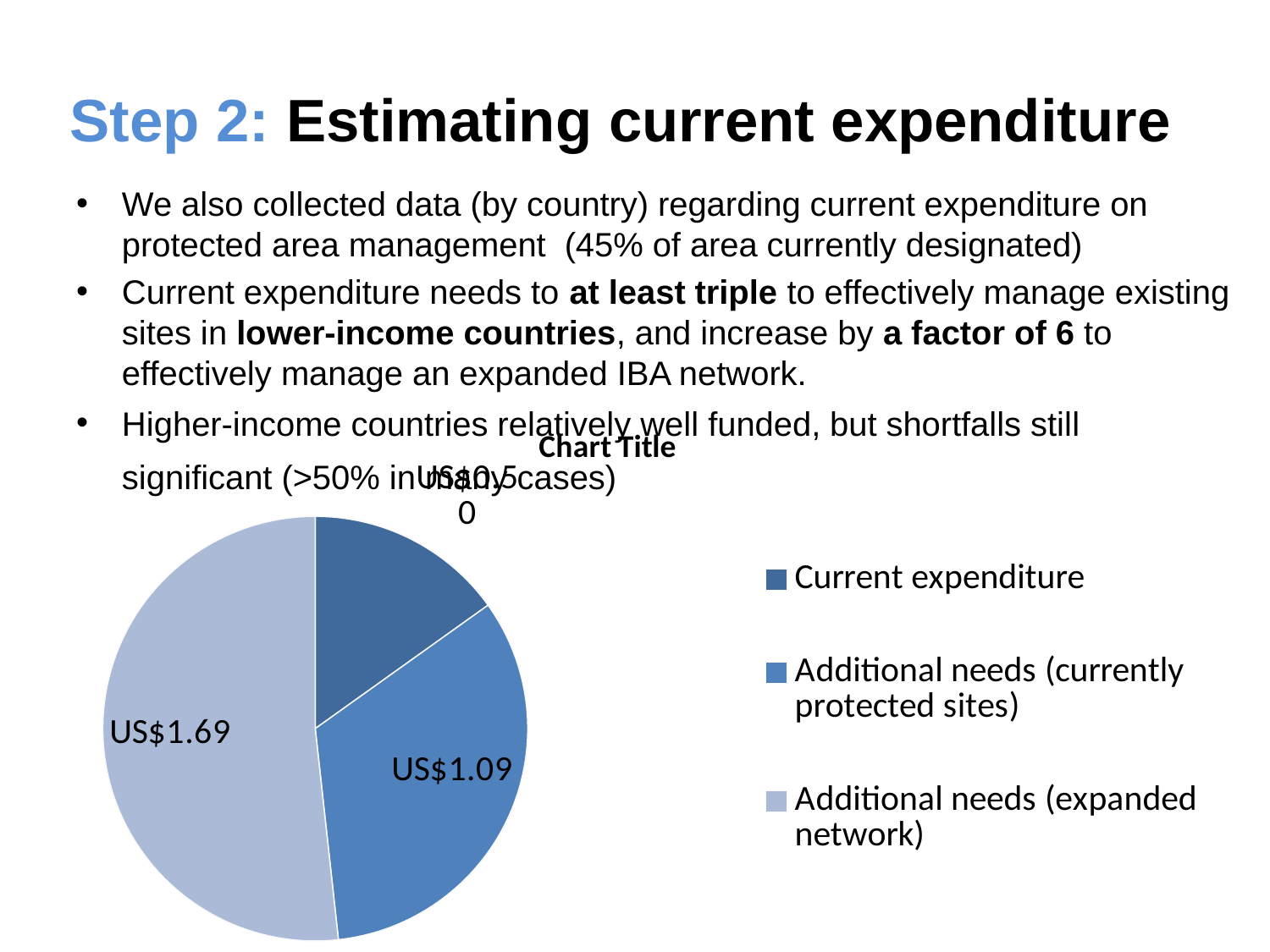
Which slice of the pie chart is the largest? Additional needs (expanded network) Which is larger: Additional needs (expanded network) or Additional needs (currently protected sites)? Additional needs (expanded network) How many entries does the chart legend list? 3 How many slices does the pie chart have? 3 What colour is the Current expenditure slice? Dark blue What value is shown for the Additional needs (expanded network) slice? US$1.69 Where is the legend positioned relative to the pie chart? To the right Which is larger: Current expenditure or Additional needs (currently protected sites)? Additional needs (currently protected sites) Which slice of the pie chart is the smallest? Current expenditure What kind of chart is shown on the slide? Pie chart What value is shown for the Additional needs (currently protected sites) slice? US$1.09 What is the difference between the Additional needs (expanded network) value and the Additional needs (currently protected sites) value? US$0.60